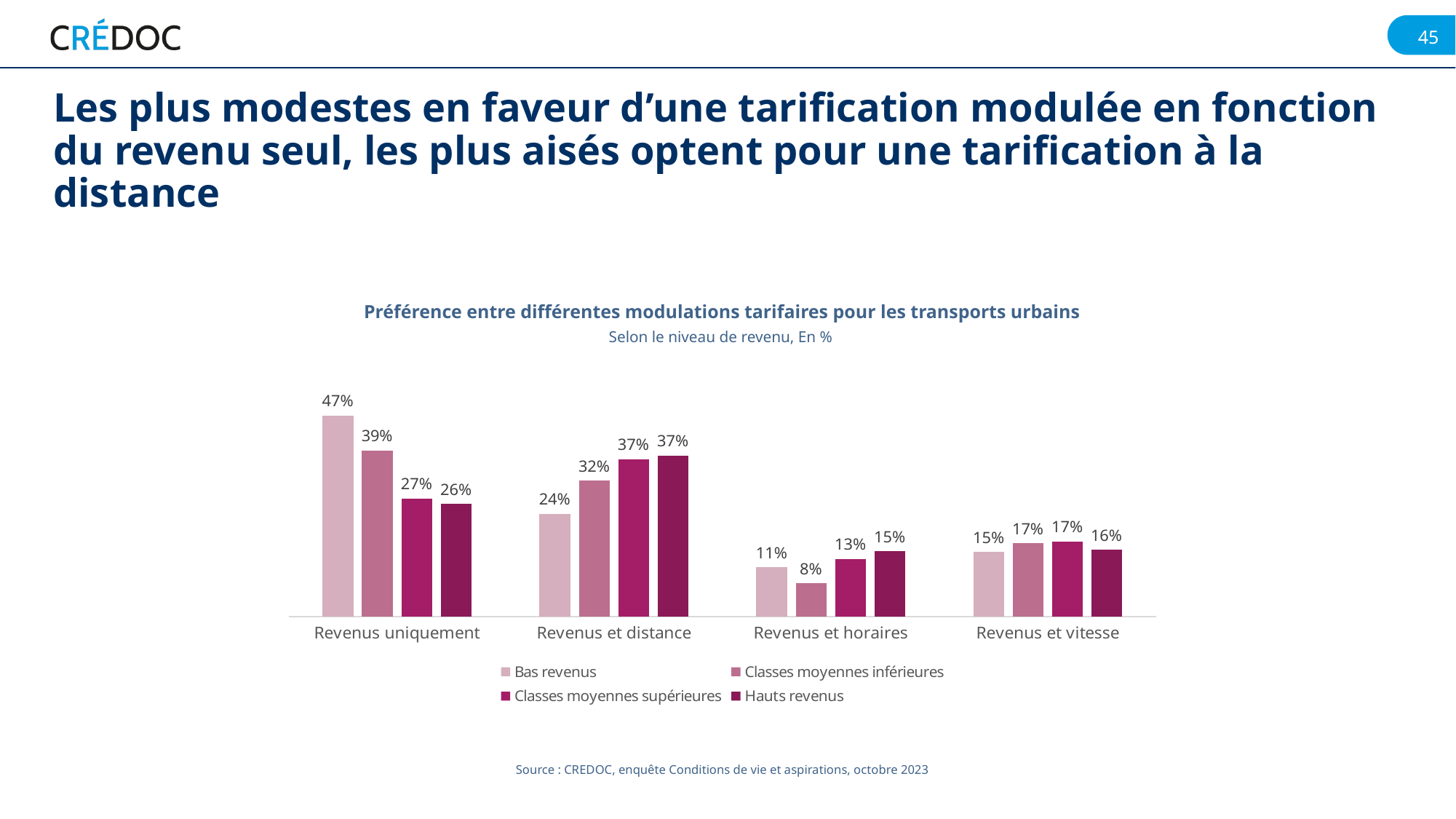
What is the value for Bas revenus in the Revenus uniquement category? 47% How many series does the legend list? 4 Which category has the lowest value for Classes moyennes inférieures? Revenus et horaires What is the value for Hauts revenus in the Revenus et distance category? 37% What is the value for Classes moyennes inférieures in the Revenus et horaires category? 8% How many categories are shown on the x axis? 4 What kind of chart is shown on the slide? Bar chart Which category has the highest value for Bas revenus? Revenus uniquement What is the difference between the Bas revenus and Hauts revenus values in the Revenus uniquement category? 21 percentage points In the Revenus et distance category, which is larger: the value for Bas revenus or the value for Classes moyennes supérieures? Classes moyennes supérieures Across the four categories from left to right, do the values for Bas revenus generally rise or fall? Fall What is the title of the chart? Préférence entre différentes modulations tarifaires pour les transports urbains